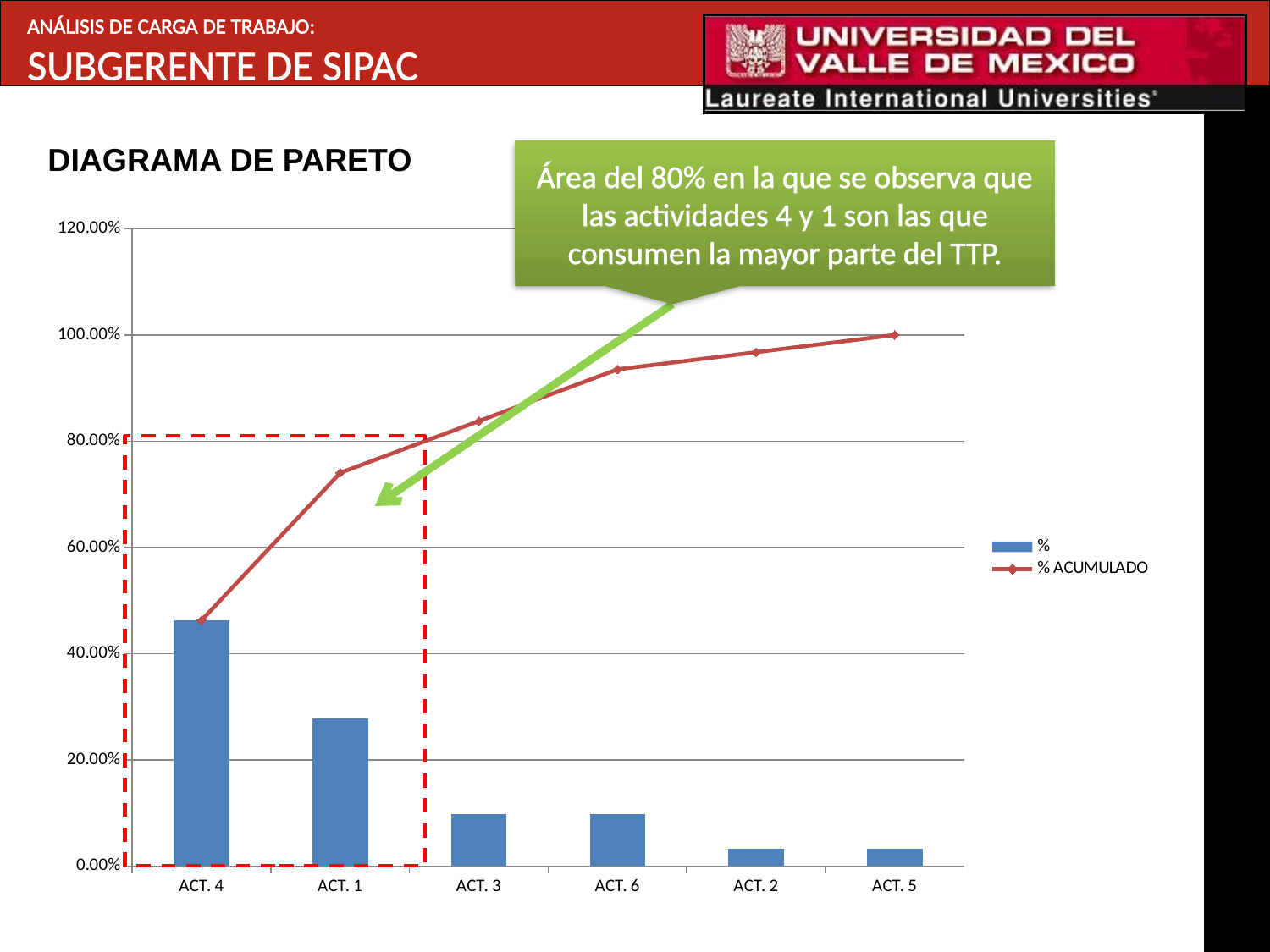
Which activity has the highest % bar? ACT. 4 How many series does the chart legend list? 2 What is the title of the chart? DIAGRAMA DE PARETO How many activity categories are shown on the x axis? 6 Is the % value for ACT. 1 greater or less than 20.00%? greater What is the % ACUMULADO value at ACT. 5? 100.00% Do the % ACUMULADO values rise or fall from ACT. 4 to ACT. 5? rise Is the % value for ACT. 3 greater or less than 20.00%? less Is the % value for ACT. 4 greater or less than 40.00%? greater Which has the larger % bar, ACT. 4 or ACT. 1? ACT. 4 What are the two series named in the legend? % and % ACUMULADO